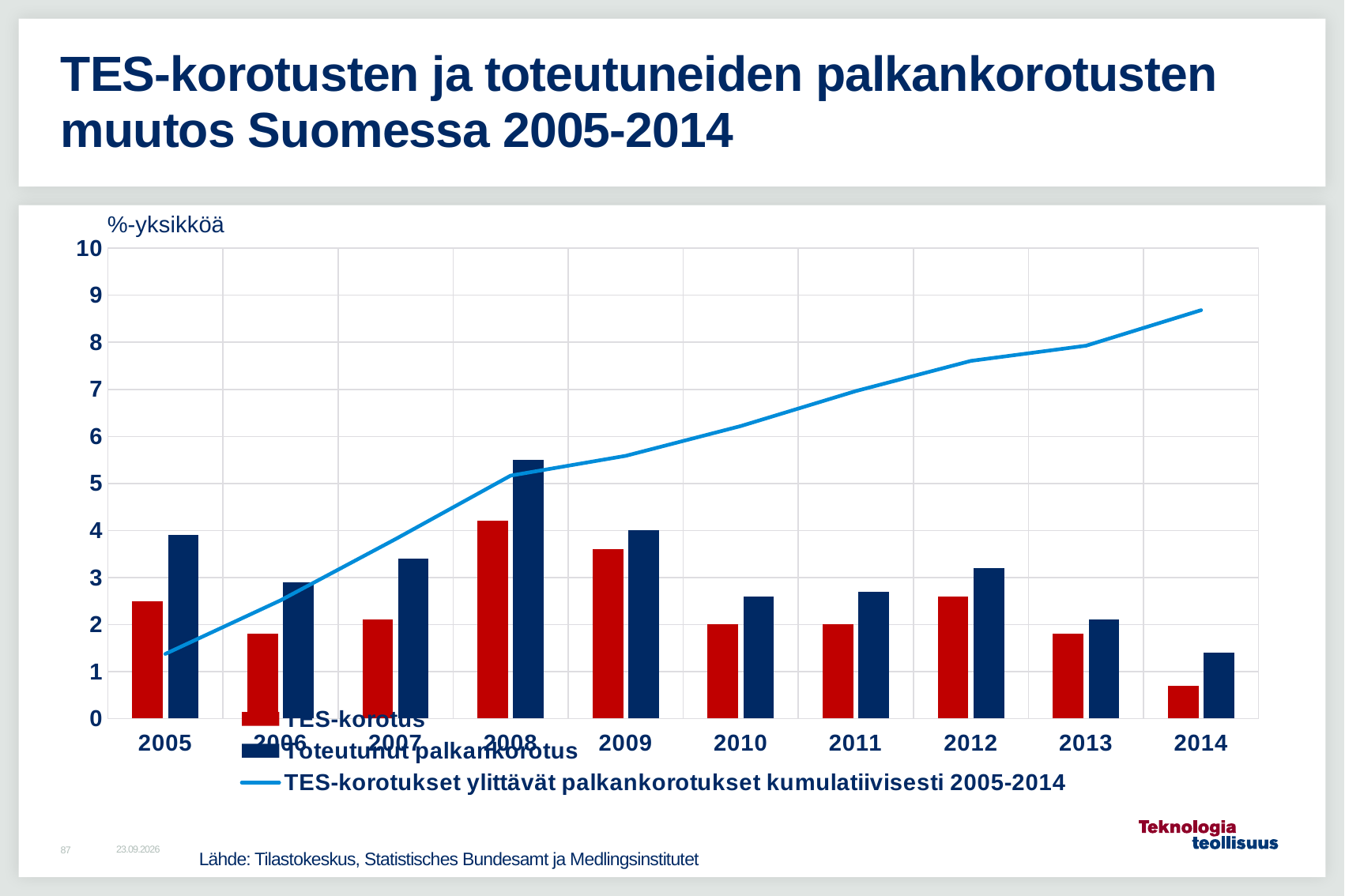
How many series does the legend list? 3 Is the TES-korotus value for 2014 greater or less than 1? less Which is larger, the TES-korotus value for 2008 or for 2009? 2008 Does the cumulative line (TES-korotukset ylittävät palkankorotukset kumulatiivisesti 2005-2014) rise or fall from 2005 to 2014? It rises In which year is the Toteutunut palkankorotus bar highest? 2008 In which year is the TES-korotus bar lowest? 2014 Is the value of the cumulative line (TES-korotukset ylittävät palkankorotukset kumulatiivisesti) in 2014 greater or less than 8? greater In which year is the TES-korotus bar highest? 2008 What kind of chart is shown on the slide? A combined bar and line chart How many years are shown on the x axis? 10 Is the Toteutunut palkankorotus value for 2008 greater or less than 5? greater In which year is the Toteutunut palkankorotus bar lowest? 2014